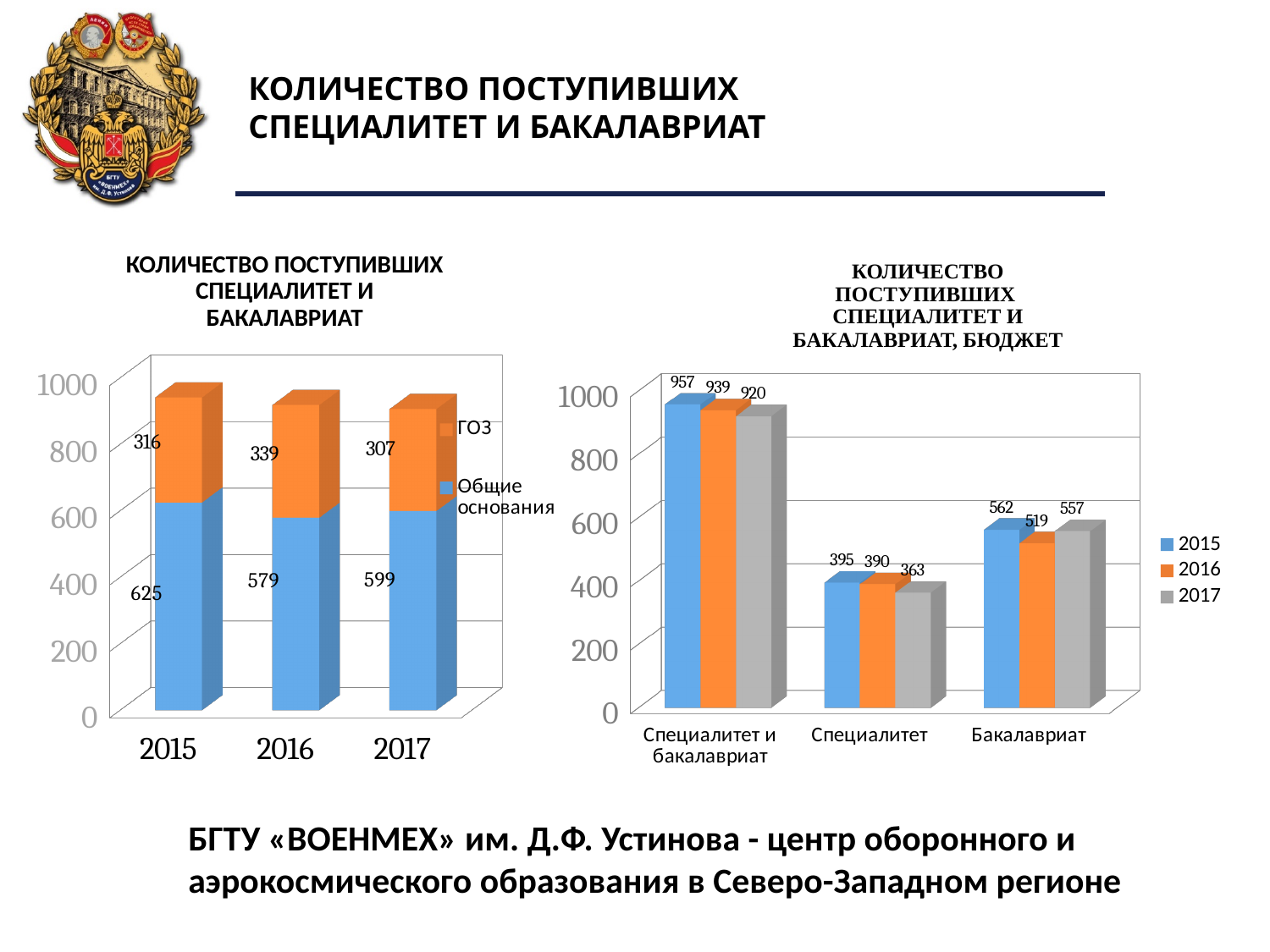
In the right chart (КОЛИЧЕСТВО ПОСТУПИВШИХ СПЕЦИАЛИТЕТ И БАКАЛАВРИАТ, БЮДЖЕТ), how many categories are shown on the x axis? 3 What kind of chart is the right chart (КОЛИЧЕСТВО ПОСТУПИВШИХ СПЕЦИАЛИТЕТ И БАКАЛАВРИАТ, БЮДЖЕТ)? Bar chart In the left chart (КОЛИЧЕСТВО ПОСТУПИВШИХ СПЕЦИАЛИТЕТ И БАКАЛАВРИАТ), how many series does the legend list? 2 In the right chart (КОЛИЧЕСТВО ПОСТУПИВШИХ СПЕЦИАЛИТЕТ И БАКАЛАВРИАТ, БЮДЖЕТ), which year has the lowest value for Бакалавриат? 2016 In the right chart (КОЛИЧЕСТВО ПОСТУПИВШИХ СПЕЦИАЛИТЕТ И БАКАЛАВРИАТ, БЮДЖЕТ), what is the difference between the 2015 and 2017 values for Специалитет и бакалавриат? 37 In the left chart (КОЛИЧЕСТВО ПОСТУПИВШИХ СПЕЦИАЛИТЕТ И БАКАЛАВРИАТ), what is the value of ГОЗ for 2016? 339 In the right chart (КОЛИЧЕСТВО ПОСТУПИВШИХ СПЕЦИАЛИТЕТ И БАКАЛАВРИАТ, БЮДЖЕТ), what is the value for Специалитет in 2017? 363 In the left chart (КОЛИЧЕСТВО ПОСТУПИВШИХ СПЕЦИАЛИТЕТ И БАКАЛАВРИАТ), what is the difference between Общие основания in 2015 and 2016? 46 In the left chart (КОЛИЧЕСТВО ПОСТУПИВШИХ СПЕЦИАЛИТЕТ И БАКАЛАВРИАТ), which year has the highest ГОЗ value? 2016 In the left chart (КОЛИЧЕСТВО ПОСТУПИВШИХ СПЕЦИАЛИТЕТ И БАКАЛАВРИАТ), what is the total of the stacked bar for 2017? 906 In the left chart (КОЛИЧЕСТВО ПОСТУПИВШИХ СПЕЦИАЛИТЕТ И БАКАЛАВРИАТ), what is the value of Общие основания for 2015? 625 In the right chart (КОЛИЧЕСТВО ПОСТУПИВШИХ СПЕЦИАЛИТЕТ И БАКАЛАВРИАТ, БЮДЖЕТ), what is the value for Бакалавриат in 2015? 562